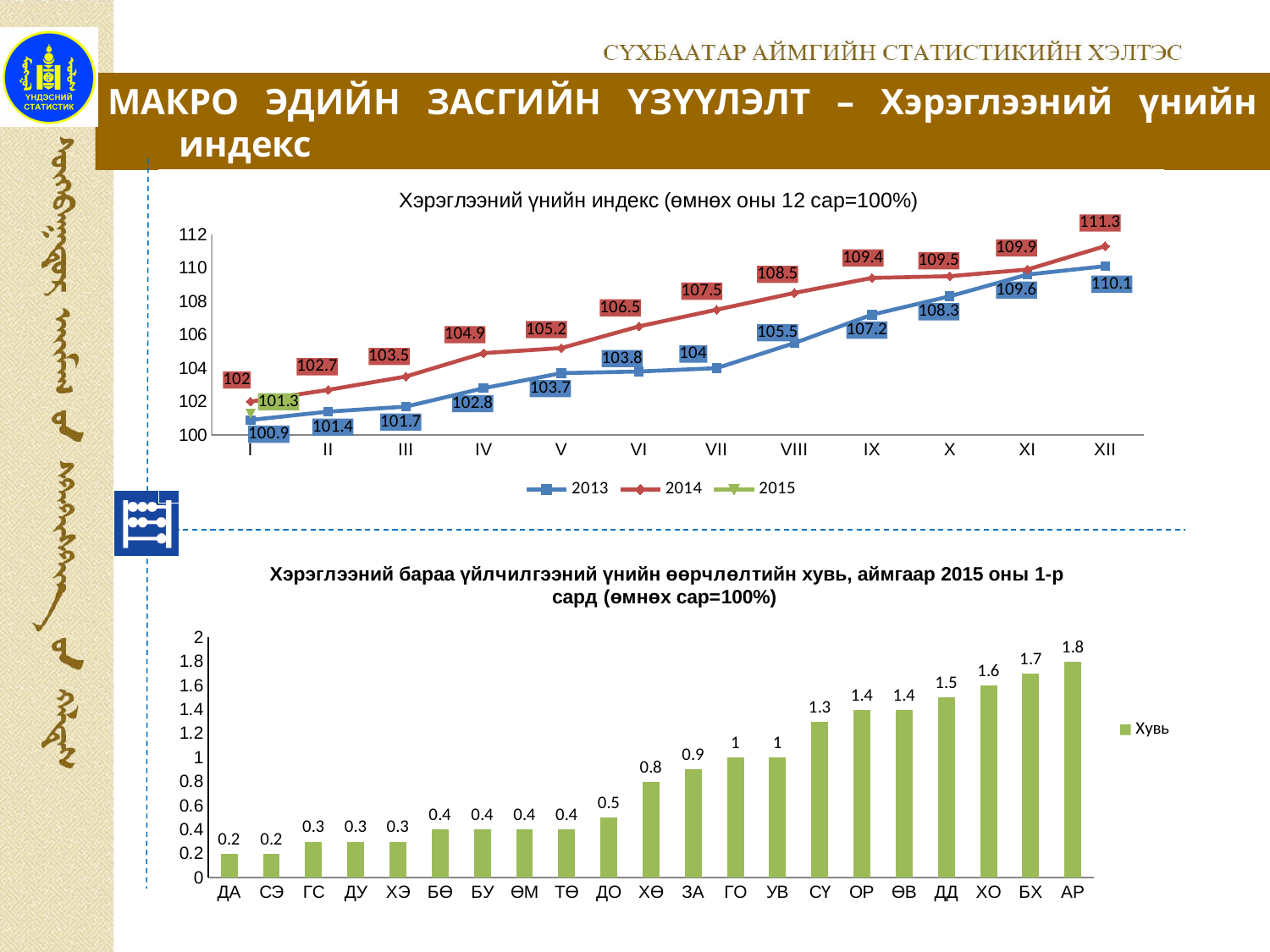
What kind of chart is the bottom chart (Хэрэглээний бараа үйлчилгээний үнийн өөрчлөлтийн хувь)? bar chart In the bottom chart (Хэрэглээний бараа үйлчилгээний үнийн өөрчлөлтийн хувь), how many categories are shown on the x axis? 21 In the bottom chart (Хэрэглээний бараа үйлчилгээний үнийн өөрчлөлтийн хувь), what is the difference between the values for АР and ДО? 1.3 In the top chart (Хэрэглээний үнийн индекс), what is the value for 2014 in month XII? 111.3 In the top chart (Хэрэглээний үнийн индекс), how many series does the legend list? 3 In the top chart (Хэрэглээний үнийн индекс), what is the difference between the 2014 and 2013 values in month XII? 1.2 In the top chart (Хэрэглээний үнийн индекс), which is larger in month IV: the 2013 value or the 2014 value? 2014 In the bottom chart (Хэрэглээний бараа үйлчилгээний үнийн өөрчлөлтийн хувь), what is the value for СҮ? 1.3 In the top chart (Хэрэглээний үнийн индекс), what is the value for 2015 in month I? 101.3 In the top chart (Хэрэглээний үнийн индекс), what is the value for 2013 in month VIII? 105.5 In the bottom chart (Хэрэглээний бараа үйлчилгээний үнийн өөрчлөлтийн хувь), which category has the highest value? АР In the top chart (Хэрэглээний үнийн индекс), does the 2013 series rise or fall from month I to month XII? rise